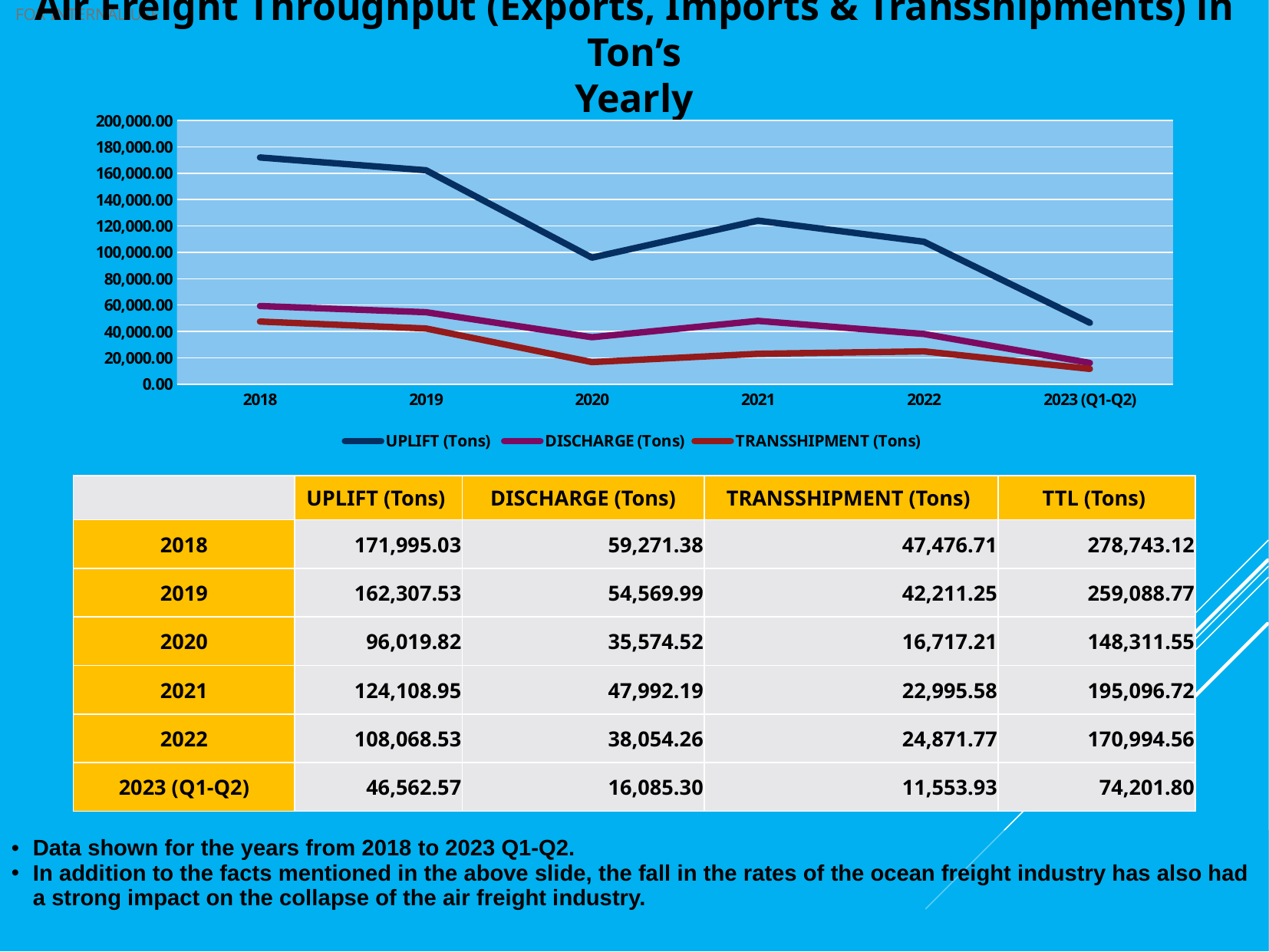
How many time points are plotted along the x axis of the chart? 6 In which period is the TRANSSHIPMENT (Tons) value lowest? 2023 (Q1-Q2) What type of chart is shown on the slide? line chart What is the TRANSSHIPMENT (Tons) value for 2023 (Q1-Q2)? 11,553.93 What is the DISCHARGE (Tons) value for 2022? 38,054.26 What is the difference between the UPLIFT (Tons) values for 2018 and 2019? 9,687.50 What is the UPLIFT (Tons) value for 2020? 96,019.82 In which year is the UPLIFT (Tons) value highest? 2018 Does the UPLIFT (Tons) line generally rise or fall from 2018 to 2023 (Q1-Q2)? fall How many series does the chart legend list? 3 Is the UPLIFT (Tons) value for 2020 greater or less than 100,000.00? less Which is larger, the DISCHARGE (Tons) value for 2021 or for 2022? 2021